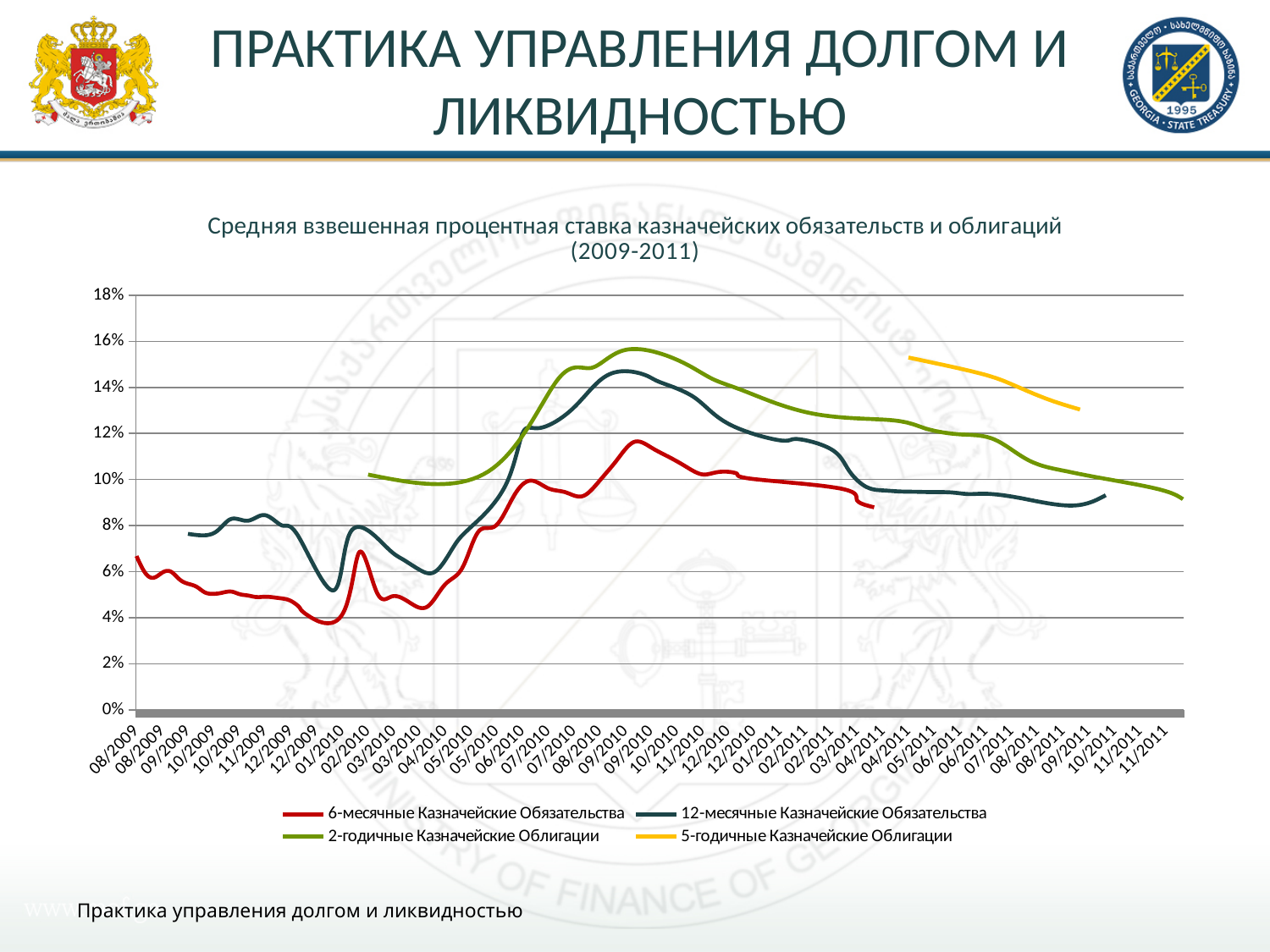
Is the value for 2-годичные Казначейские Облигации at 09/2010 greater or less than 14%? greater Which series reaches the lowest value on the chart? 6-месячные Казначейские Обязательства At 05/2011, which is higher: 5-годичные Казначейские Облигации or 2-годичные Казначейские Облигации? 5-годичные Казначейские Облигации Does the 2-годичные Казначейские Облигации series rise or fall from 09/2010 to 11/2011? fall What kind of chart is shown on the slide? line chart Which series is drawn in yellow? 5-годичные Казначейские Облигации Is the value for 12-месячные Казначейские Обязательства at 01/2010 greater or less than 6%? less Is the value for 5-годичные Казначейские Облигации at 05/2011 greater or less than 14%? greater At 09/2010, which is higher: 2-годичные Казначейские Облигации or 6-месячные Казначейские Обязательства? 2-годичные Казначейские Облигации What is the title of the chart? Средняя взвешенная процентная ставка казначейских обязательств и облигаций (2009-2011) How many series does the legend list? 4